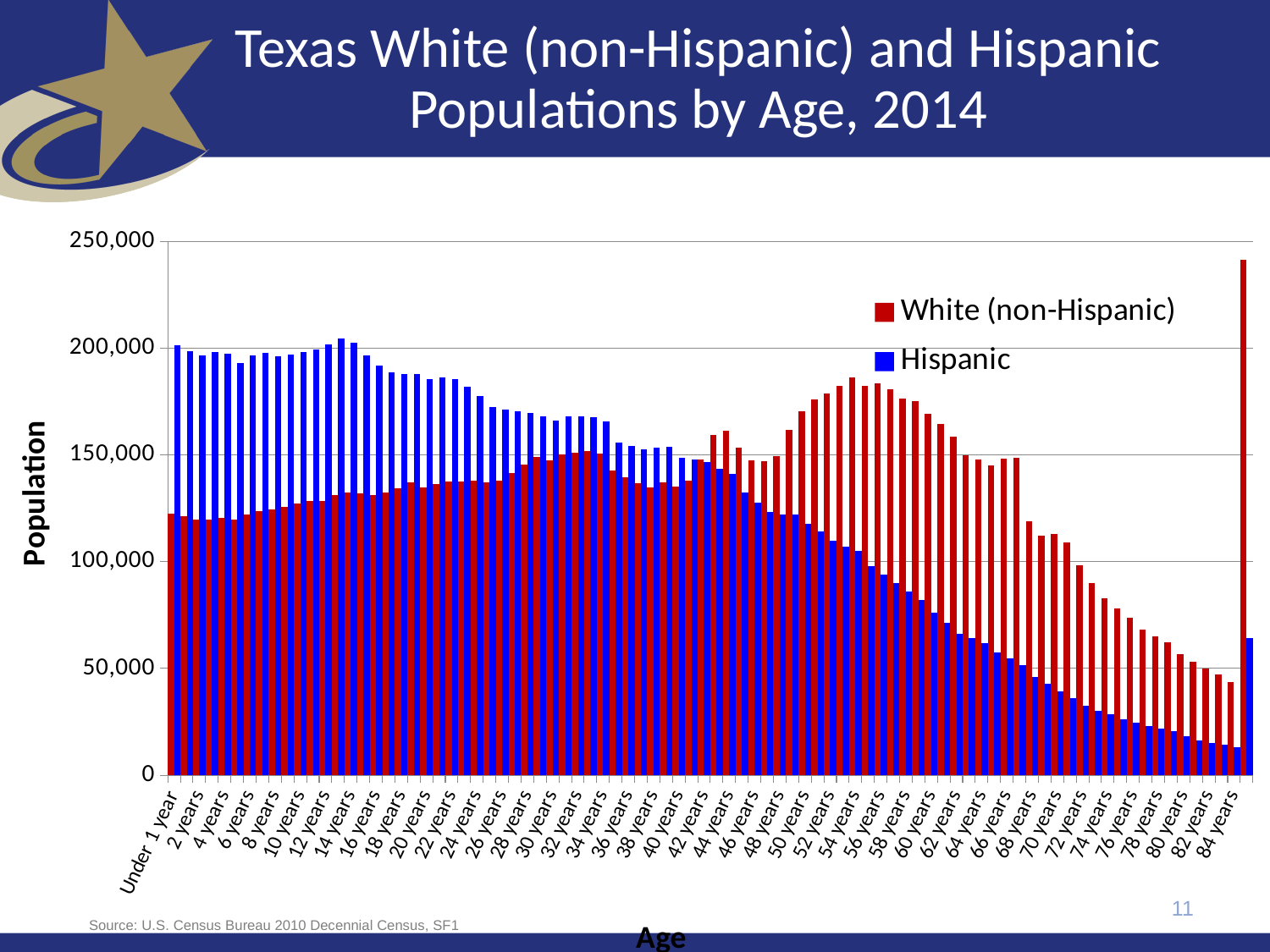
Is the Hispanic value for 60 years greater or less than 100,000? less Which colour represents the Hispanic series in the chart? blue Is the Hispanic value for 14 years greater or less than 150,000? greater Is the White (non-Hispanic) value for Under 1 year greater or less than 100,000? greater What kind of chart is shown on the slide? bar chart Do the Hispanic values rise or fall from 14 years to 84 years? fall At 2 years, which series has the larger value, White (non-Hispanic) or Hispanic? Hispanic At 54 years, which series has the larger value, White (non-Hispanic) or Hispanic? White (non-Hispanic) How many series does the legend list? 2 What is the label of the vertical axis? Population